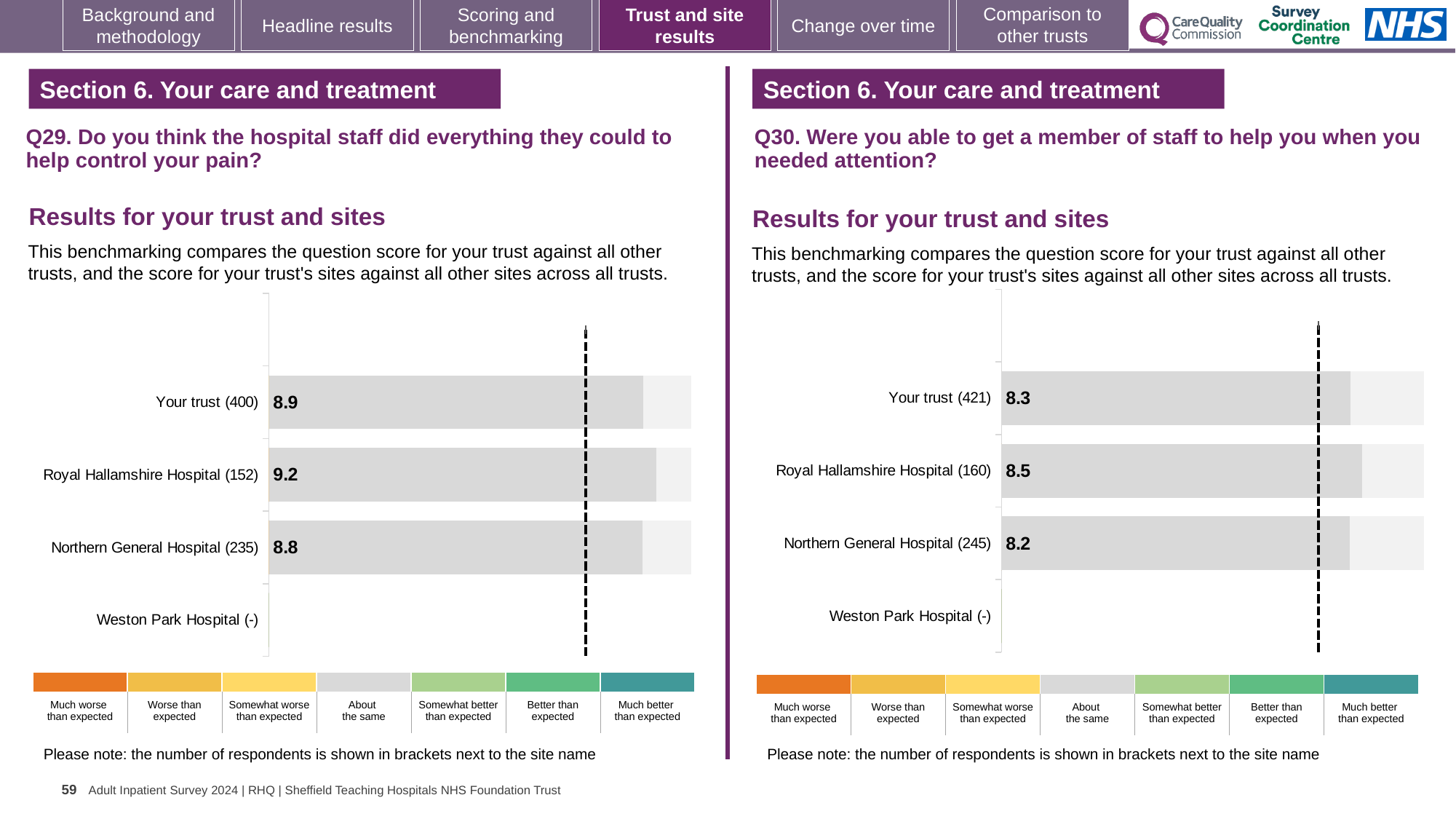
In the Q30 chart on the right, which site or trust has the lowest score among those with a score shown? Northern General Hospital How many sites or trusts are listed on the y axis of the Q29 chart on the left? 4 In the Q29 chart on the left, what is the score for Your trust? 8.9 In the Q30 chart on the right, what is the score for Your trust? 8.3 In the Q29 chart on the left, how many respondents are shown in brackets for Northern General Hospital? 235 In the Q29 chart on the left, what is the score for Royal Hallamshire Hospital? 9.2 In the Q30 chart on the right, what is the difference between the scores for Royal Hallamshire Hospital and Your trust? 0.2 What kind of chart is the Q30 chart on the right? Bar chart In the Q29 chart on the left, which site or trust has the highest score? Royal Hallamshire Hospital In the Q30 chart on the right, which has the larger score, Royal Hallamshire Hospital or Your trust? Royal Hallamshire Hospital In the Q30 chart on the right, what is the score for Northern General Hospital? 8.2 In the Q29 chart on the left, what is the difference between the scores for Royal Hallamshire Hospital and Northern General Hospital? 0.4